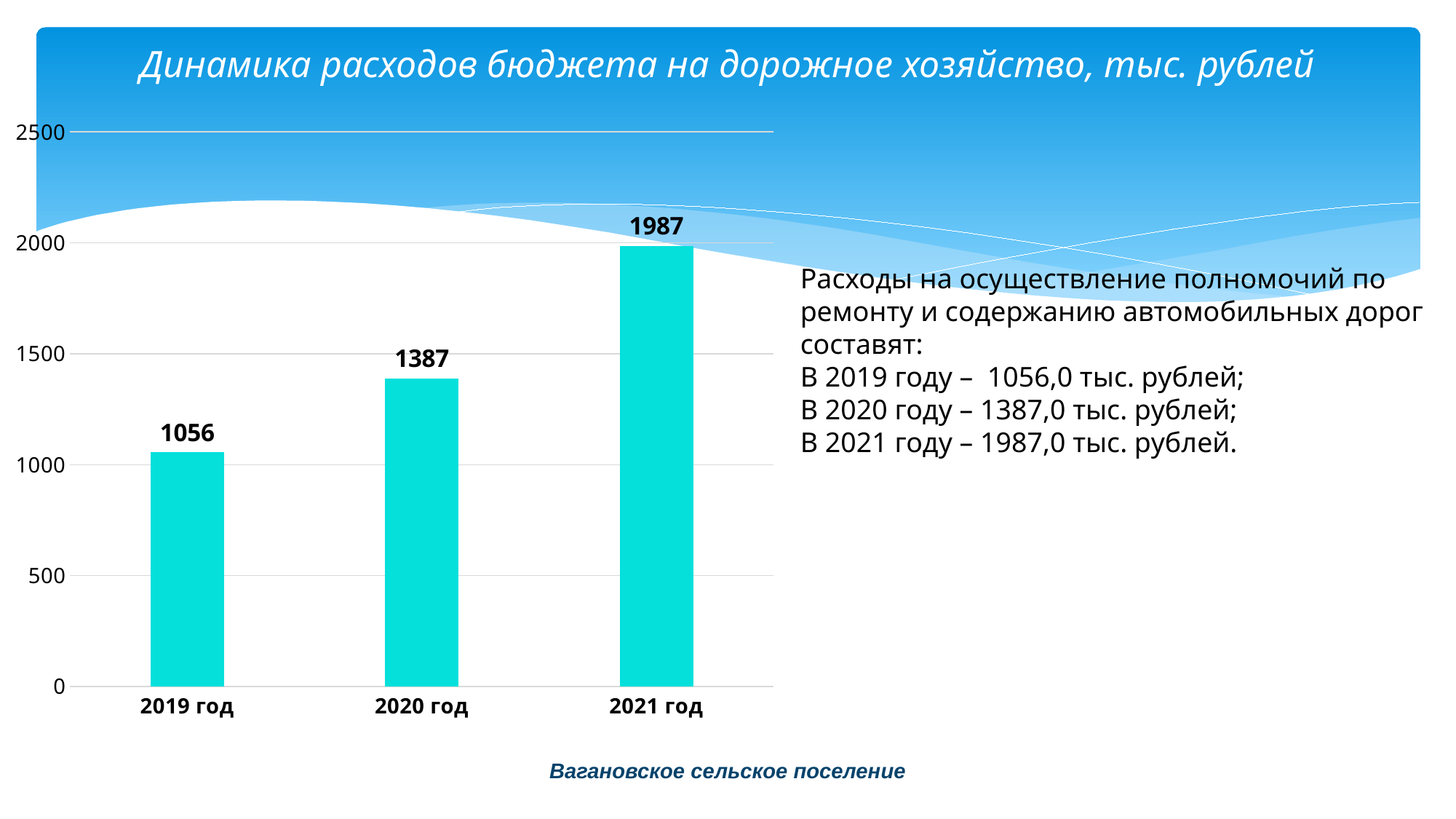
What is the value for 2020 год? 1387 Which is larger, the value for 2019 год or the value for 2020 год? 2020 год What is the difference between the values for 2021 год and 2020 год? 600 What is the value for 2019 год? 1056 Which year has the lowest value? 2019 год Is the value for 2021 год greater or less than 1500? greater Do the values rise or fall from 2019 год to 2021 год? rise What is the value for 2021 год? 1987 What is the difference between the values for 2020 год and 2019 год? 331 What kind of chart is shown on the slide? bar chart How many years are shown on the chart? 3 Which year has the highest value? 2021 год